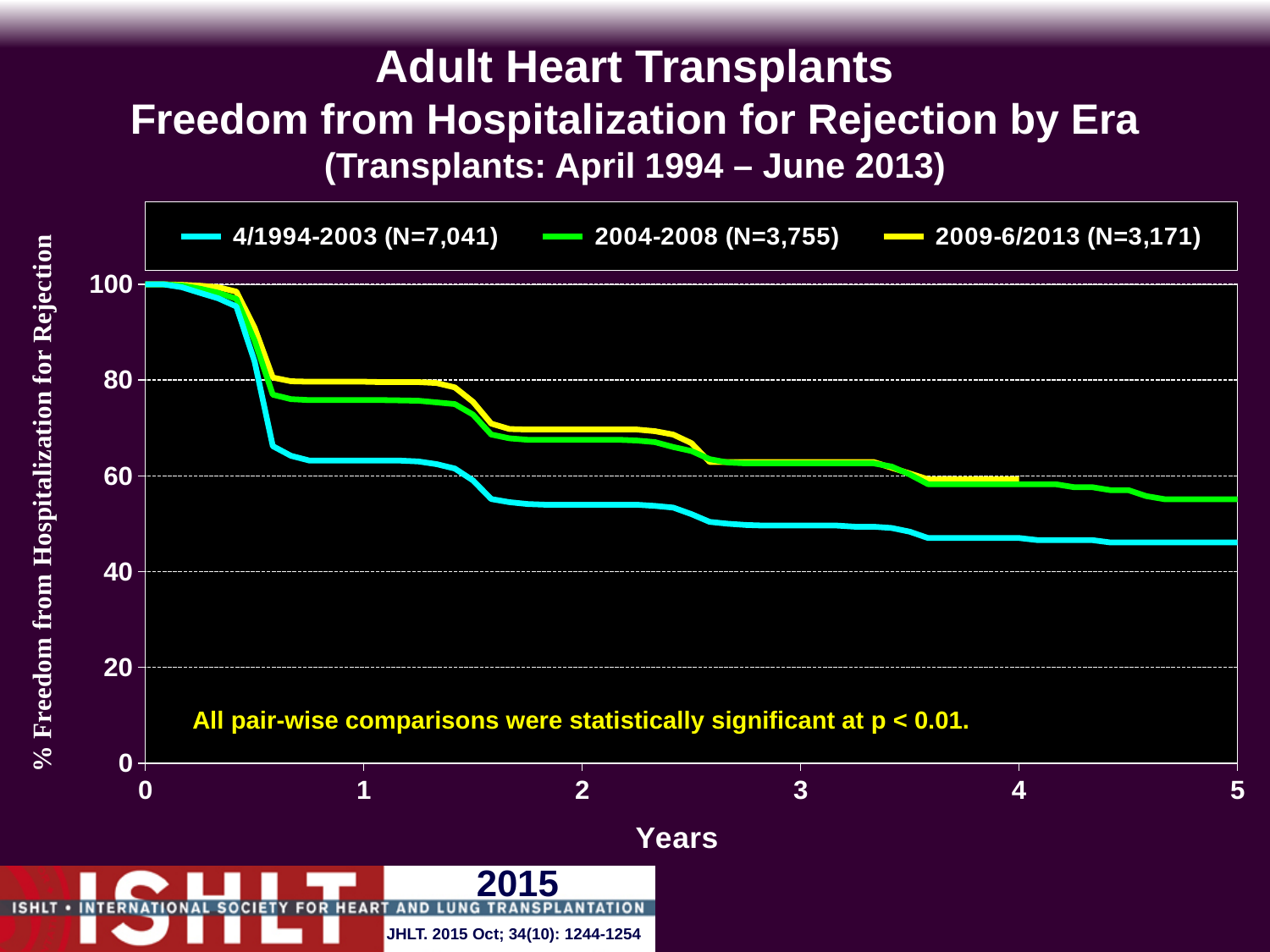
What is the label of the x axis? Years Which series has the lowest freedom from hospitalization for rejection at 5 years? 4/1994-2003 (N=7,041) Is the value for the 4/1994-2003 series at 5 years greater or less than 40? greater What is the value of each series at year 0? 100 What is the N for the 2009-6/2013 series in the legend? 3,171 Is the value for the 4/1994-2003 series at 5 years greater or less than 60? less What kind of chart is shown on the slide? line chart Is the value for the 2004-2008 series at 1 year greater or less than 80? less Do the values for the 4/1994-2003 series rise or fall as years increase? fall How many series does the legend list? 3 At 2 years, which series has the higher value: 4/1994-2003 or 2004-2008? 2004-2008